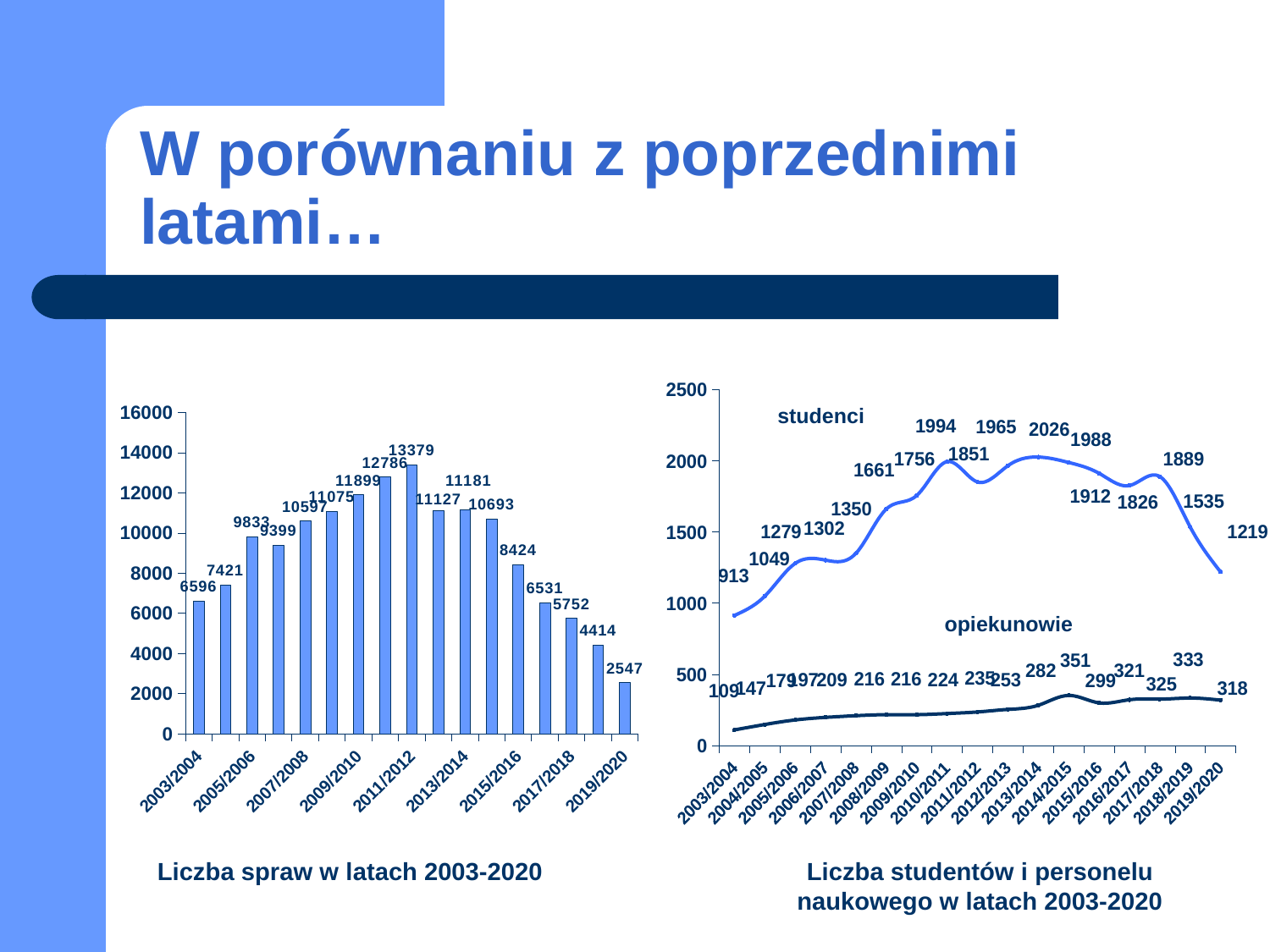
In the left chart 'Liczba spraw w latach 2003-2020', what is the difference between the highest value (13379) and the value for 2019/2020 (2547)? 10832 What kind of chart is the left chart, 'Liczba spraw w latach 2003-2020'? bar chart In the right chart 'Liczba studentów i personelu naukowego w latach 2003-2020', what is the value for 'studenci' in 2003/2004? 913 In the right chart 'Liczba studentów i personelu naukowego w latach 2003-2020', what is the highest value for the 'opiekunowie' series? 351 In the right chart 'Liczba studentów i personelu naukowego w latach 2003-2020', what is the highest value for the 'studenci' series? 2026 In the left chart 'Liczba spraw w latach 2003-2020', what is the lowest value shown? 2547 In the left chart 'Liczba spraw w latach 2003-2020', which year has the highest value? 2011/2012 In the left chart 'Liczba spraw w latach 2003-2020', do the values rise or fall from 2011/2012 to 2019/2020? fall How many bars are plotted in the left chart 'Liczba spraw w latach 2003-2020'? 17 How many series are plotted in the right chart 'Liczba studentów i personelu naukowego w latach 2003-2020'? 2 What kind of chart is the right chart, 'Liczba studentów i personelu naukowego w latach 2003-2020'? line chart In the left chart 'Liczba spraw w latach 2003-2020', what is the value for 2003/2004? 6596